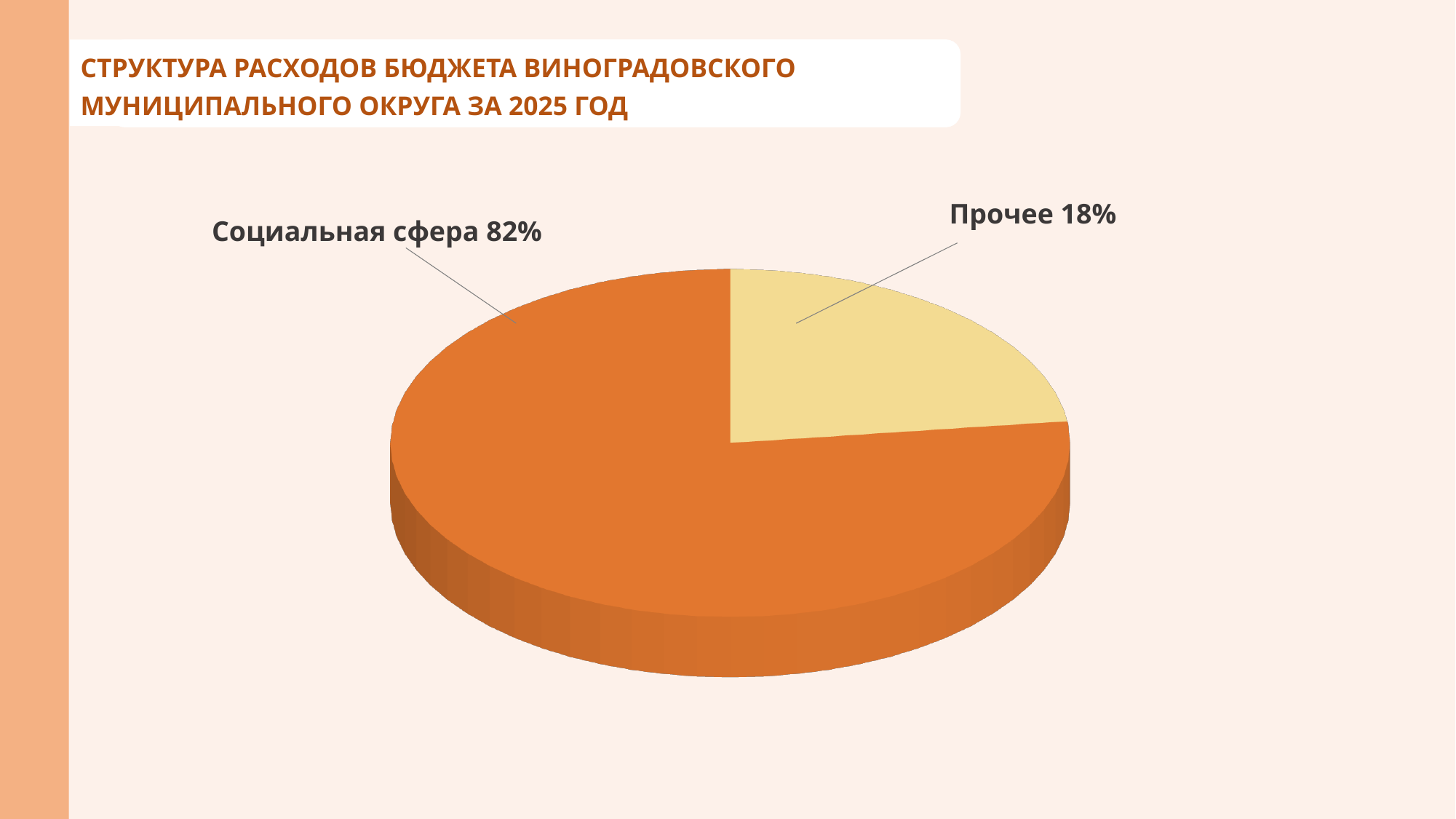
What is the title of the slide? СТРУКТУРА РАСХОДОВ БЮДЖЕТА ВИНОГРАДОВСКОГО МУНИЦИПАЛЬНОГО ОКРУГА ЗА 2025 ГОД What share of the pie does Прочее have? 18% What share of the pie does Социальная сфера have? 82% What colour is the Прочее slice of the pie? Light yellow Which is larger, the share for Социальная сфера or the share for Прочее? Социальная сфера What is the total of the two slices shown on the pie chart? 100% What kind of chart is shown on the slide? Pie chart How many slices does the pie chart have? 2 Which slice of the pie is the smallest? Прочее Which slice of the pie is the largest? Социальная сфера What is the difference in percentage points between Социальная сфера and Прочее? 64